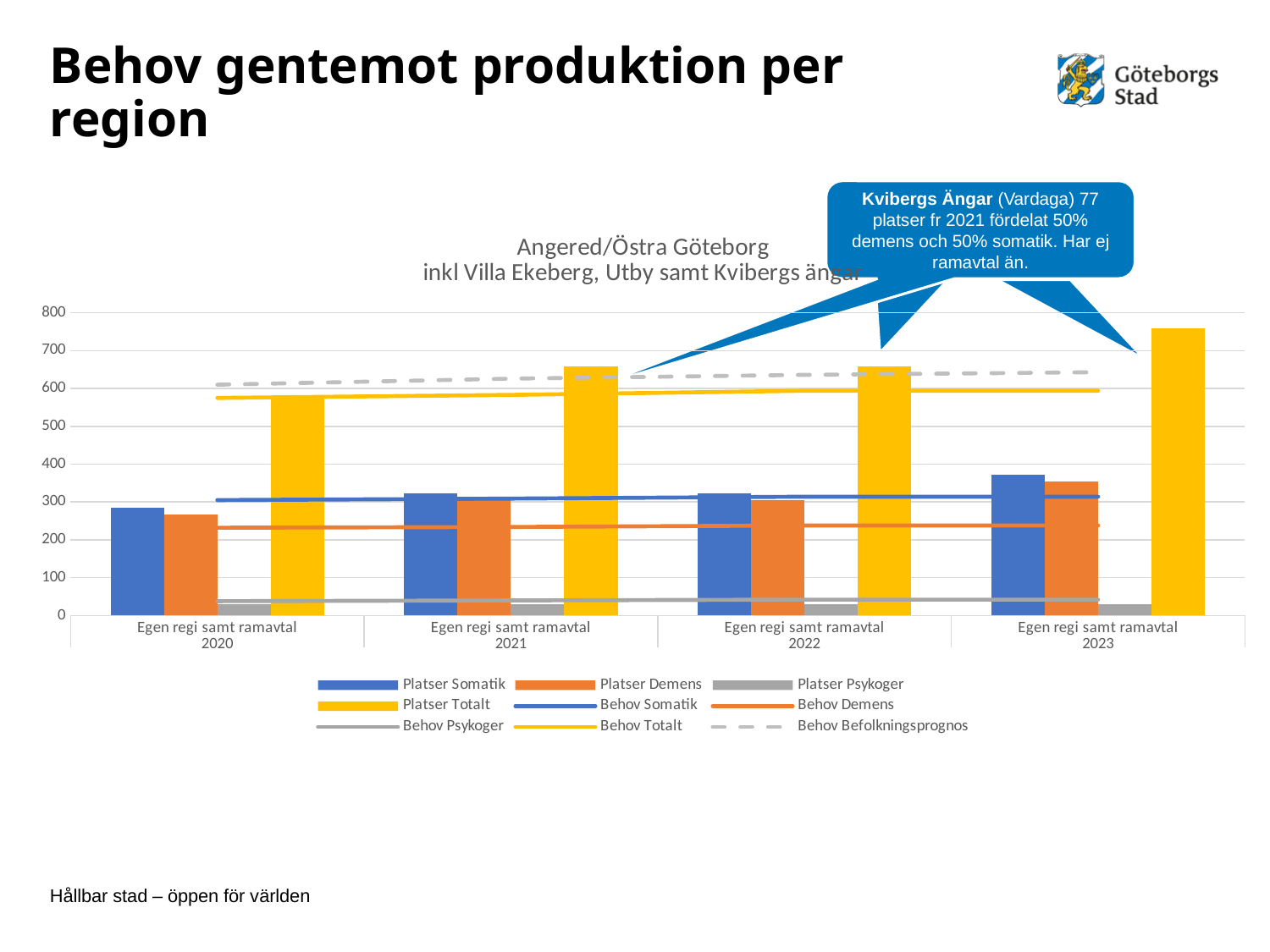
Which series is drawn as a dashed line? Behov Befolkningsprognos What kind of chart is shown on the slide? bar chart with line series In which year is the Platser Totalt bar highest? 2023 Do the Platser Totalt bars rise or fall from 2020 to 2023? rise Is the Platser Totalt bar for 2023 greater or less than 700? greater Is the Platser Somatik bar for 2023 greater or less than 300? greater Is the Platser Psykoger bar for 2020 greater or less than 100? less How many series does the legend list? 9 In 2020, which bar is taller: Platser Somatik or Platser Demens? Platser Somatik How many year categories are shown on the x axis? 4 Which bar series is the lowest in 2023? Platser Psykoger